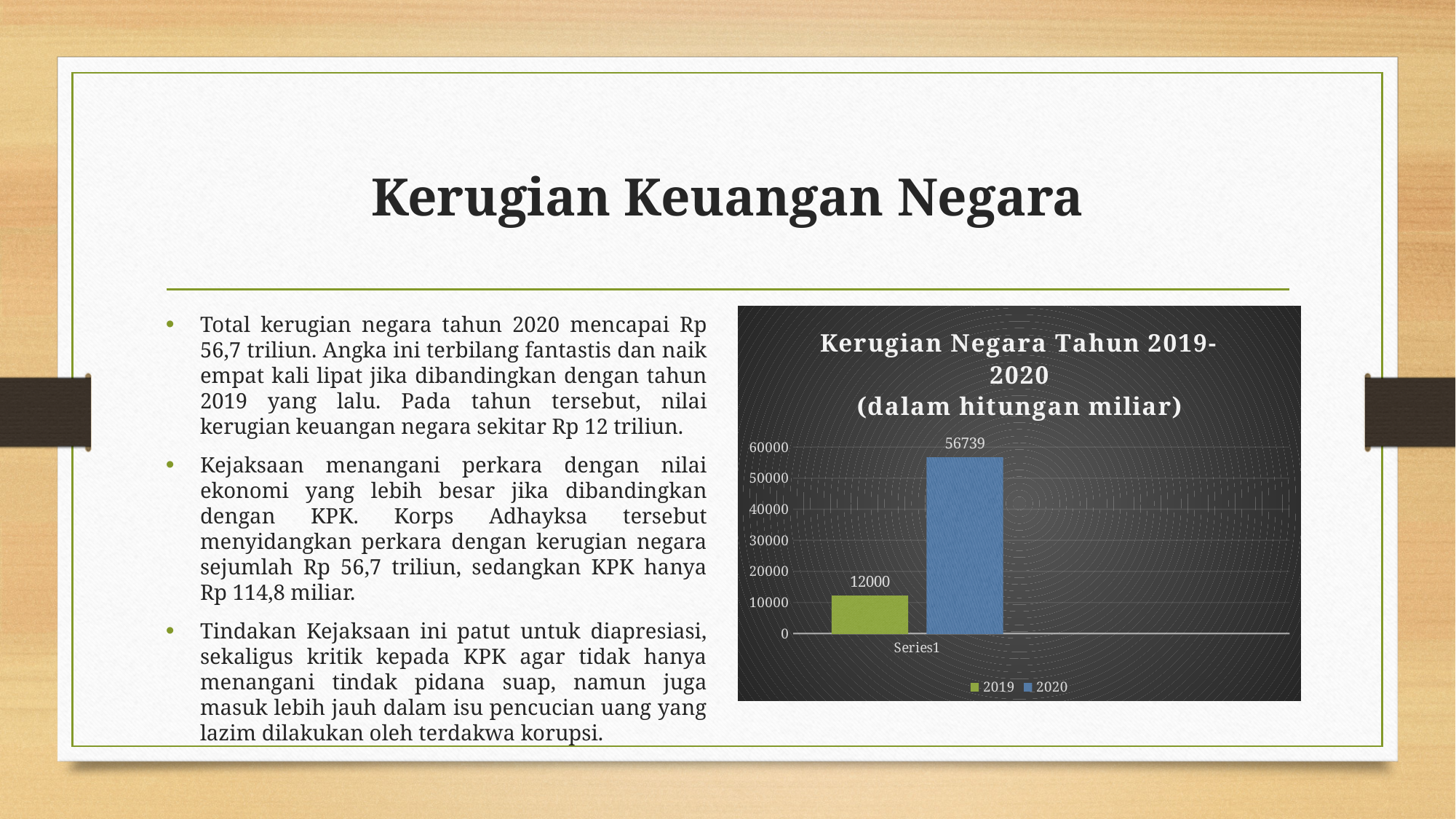
What is the title of the chart? Kerugian Negara Tahun 2019-2020 (dalam hitungan miliar) Which series has the lowest value in the chart? 2019 Which year has the higher value in the chart, 2019 or 2020? 2020 What is the value for 2020 in the chart? 56739 Is the value for 2019 greater or less than 20000? less What kind of chart is shown on the slide? Bar chart How many series does the legend list? 2 What is the highest value shown on the chart's vertical axis? 60000 What colour is the bar for 2020? Blue Is the value for 2020 greater or less than 50000? greater What is the difference between the 2020 value and the 2019 value? 44739 What is the value for 2019 in the chart? 12000